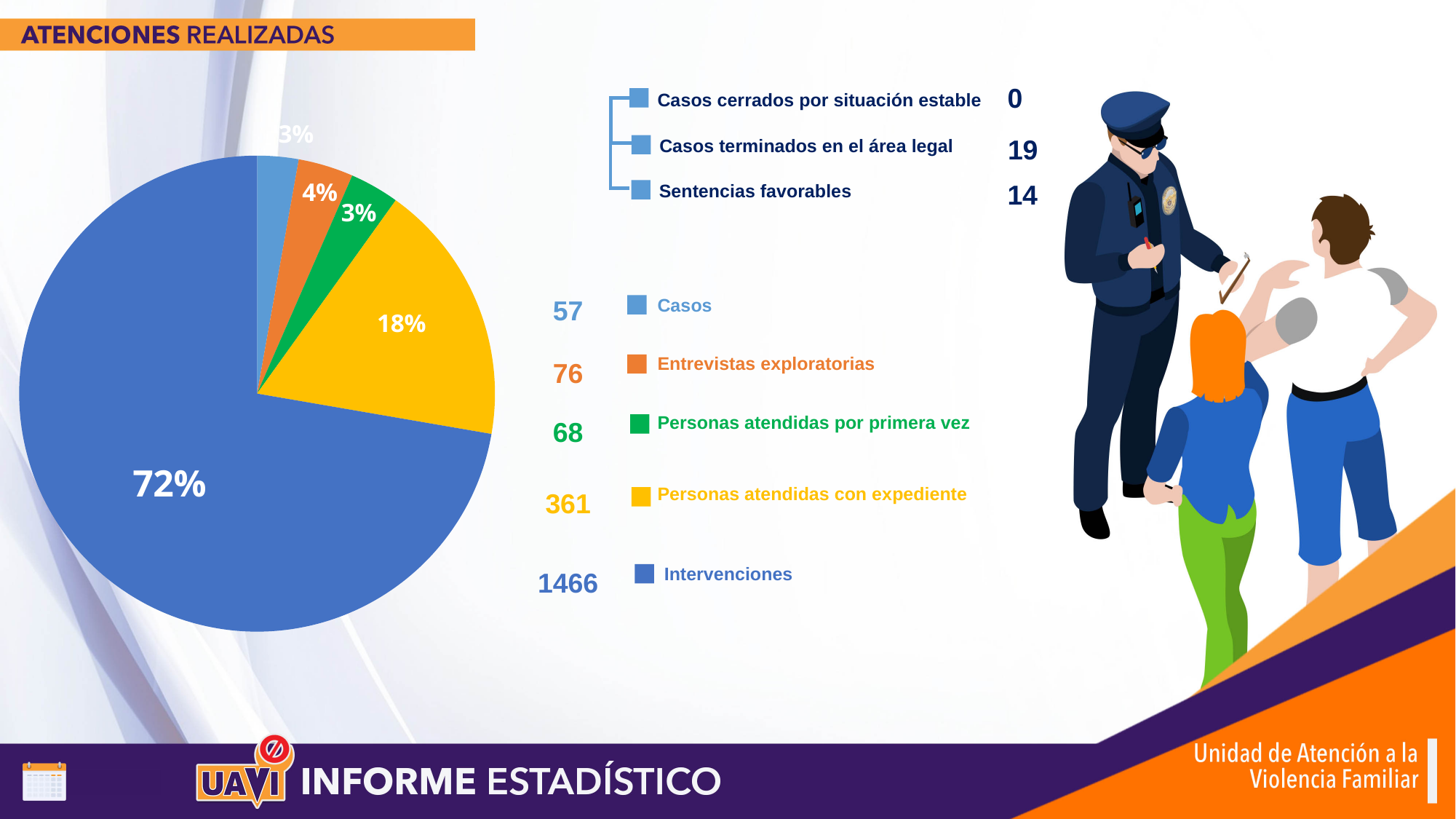
What percentage of the pie chart does Intervenciones represent? 72% What is the number shown for Intervenciones in the legend? 1466 What is the difference between the numbers for Personas atendidas con expediente and Entrevistas exploratorias? 285 What kind of chart is shown on the slide? pie chart Which category has the largest slice of the pie chart? Intervenciones What is the number shown for Personas atendidas con expediente in the legend? 361 Which is larger, Entrevistas exploratorias or Personas atendidas por primera vez? Entrevistas exploratorias How many categories are shown in the pie chart? 5 What colour is the Personas atendidas con expediente slice in the pie chart? yellow What is the number shown for Casos in the legend? 57 What percentage of the pie chart does Personas atendidas con expediente represent? 18% What percentage of the pie chart does Entrevistas exploratorias represent? 4%